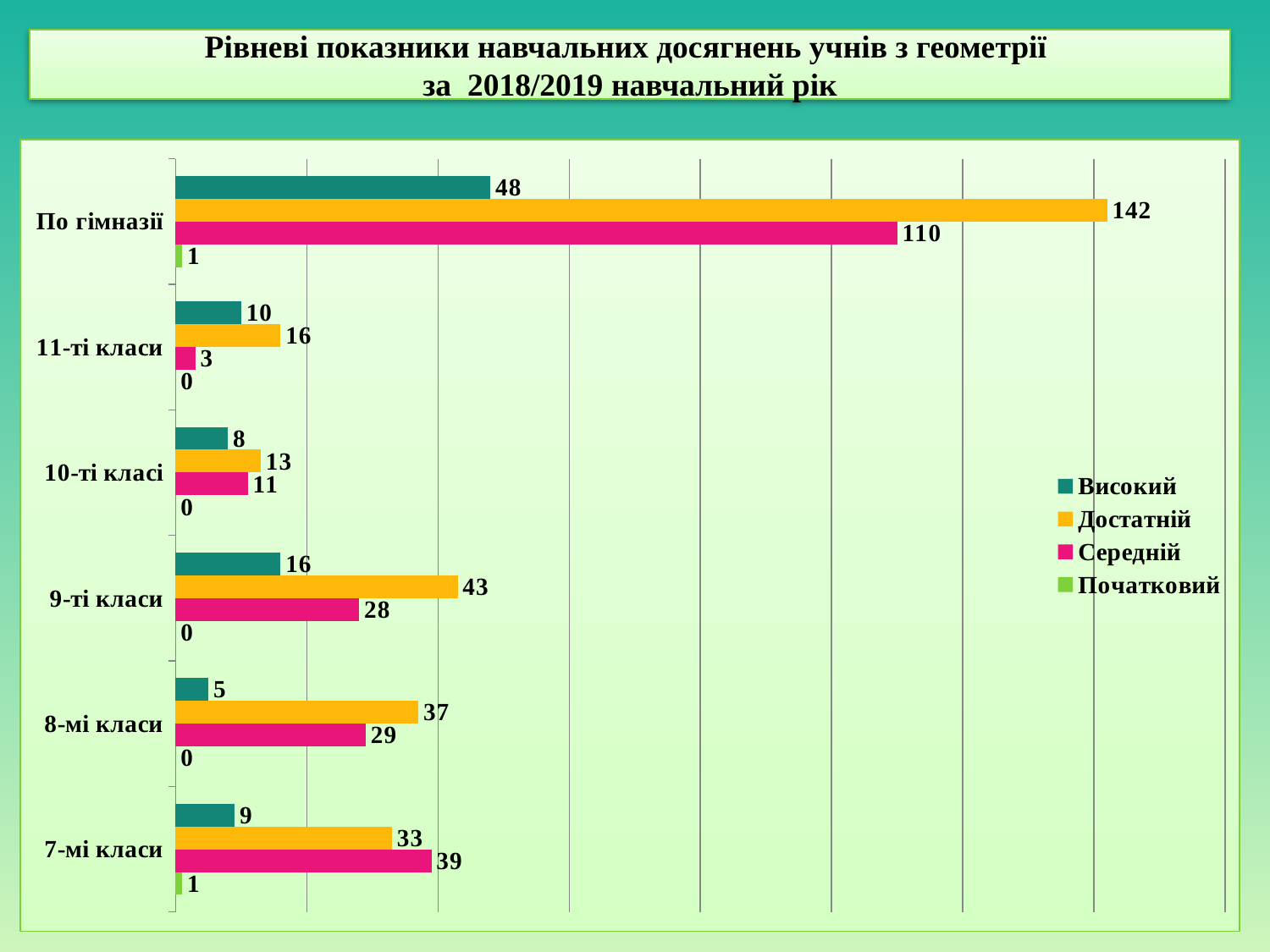
What kind of chart is shown on the slide? bar chart What is the difference between Достатній and Середній for 9-ті класи? 15 What is the value of Достатній for По гімназії? 142 What is the value of Високий for 8-мі класи? 5 How many series does the legend list? 4 Which category has the highest value for Високий? По гімназії For 7-мі класи, which is larger: Достатній or Середній? Середній What is the difference between Достатній and Середній for По гімназії? 32 Which series is shown in pink on the chart? Середній How many categories are shown on the chart? 6 What is the value of Середній for 7-мі класи? 39 Which category has the lowest value for Достатній? 10-ті класі